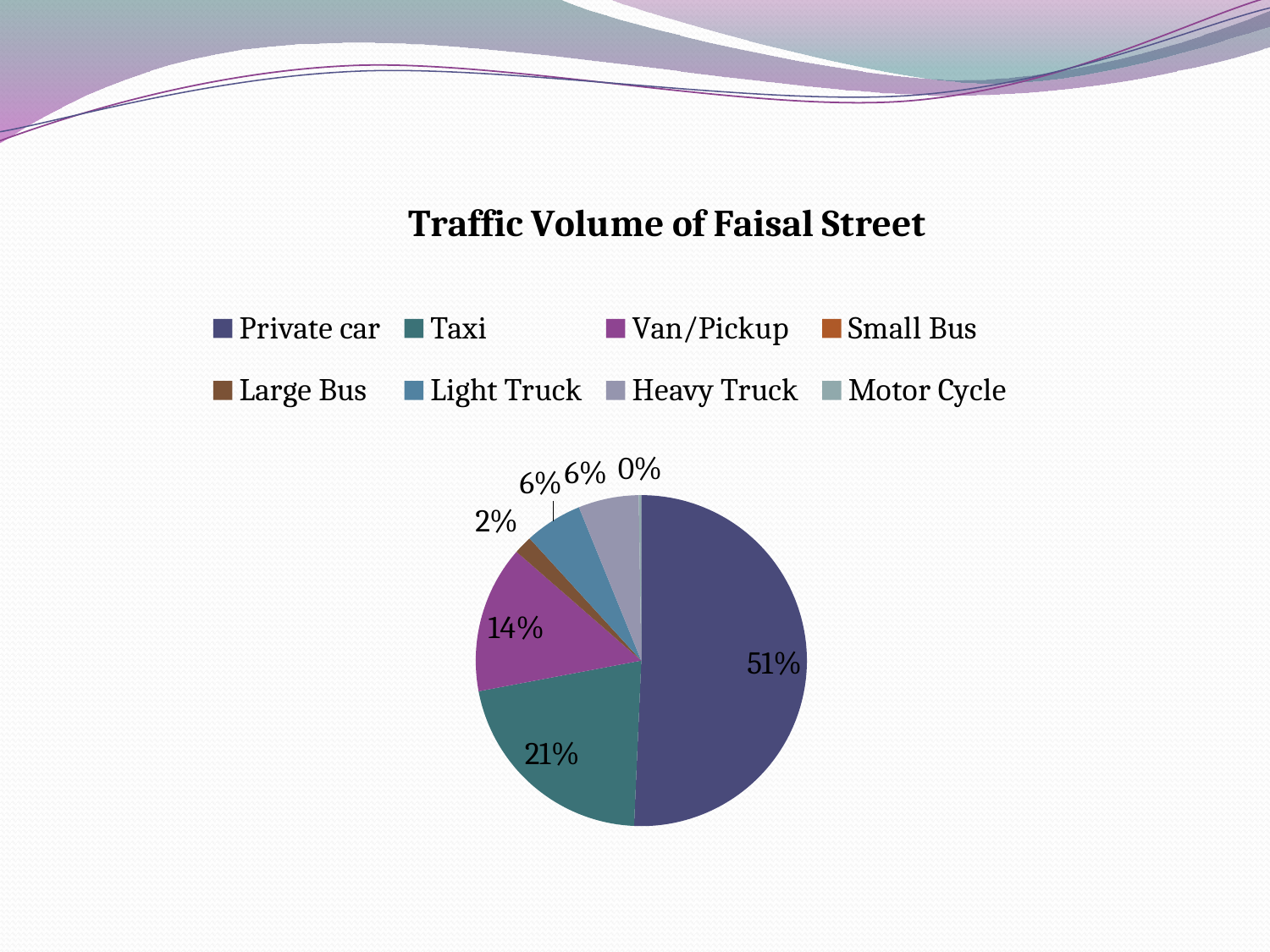
What share of the traffic volume is Taxi? 21% What is the title of the chart? Traffic Volume of Faisal Street How many categories does the legend list? 8 What share of the traffic volume is Private car? 51% What share of the traffic volume is Heavy Truck? 6% What is the combined share of Private car and Taxi? 72% What is the difference in percentage points between the Private car share and the Taxi share? 30 percentage points Which category has the largest share of the pie? Private car Which is larger, the share for Taxi or the share for Van/Pickup? Taxi What kind of chart is shown on the slide? Pie chart